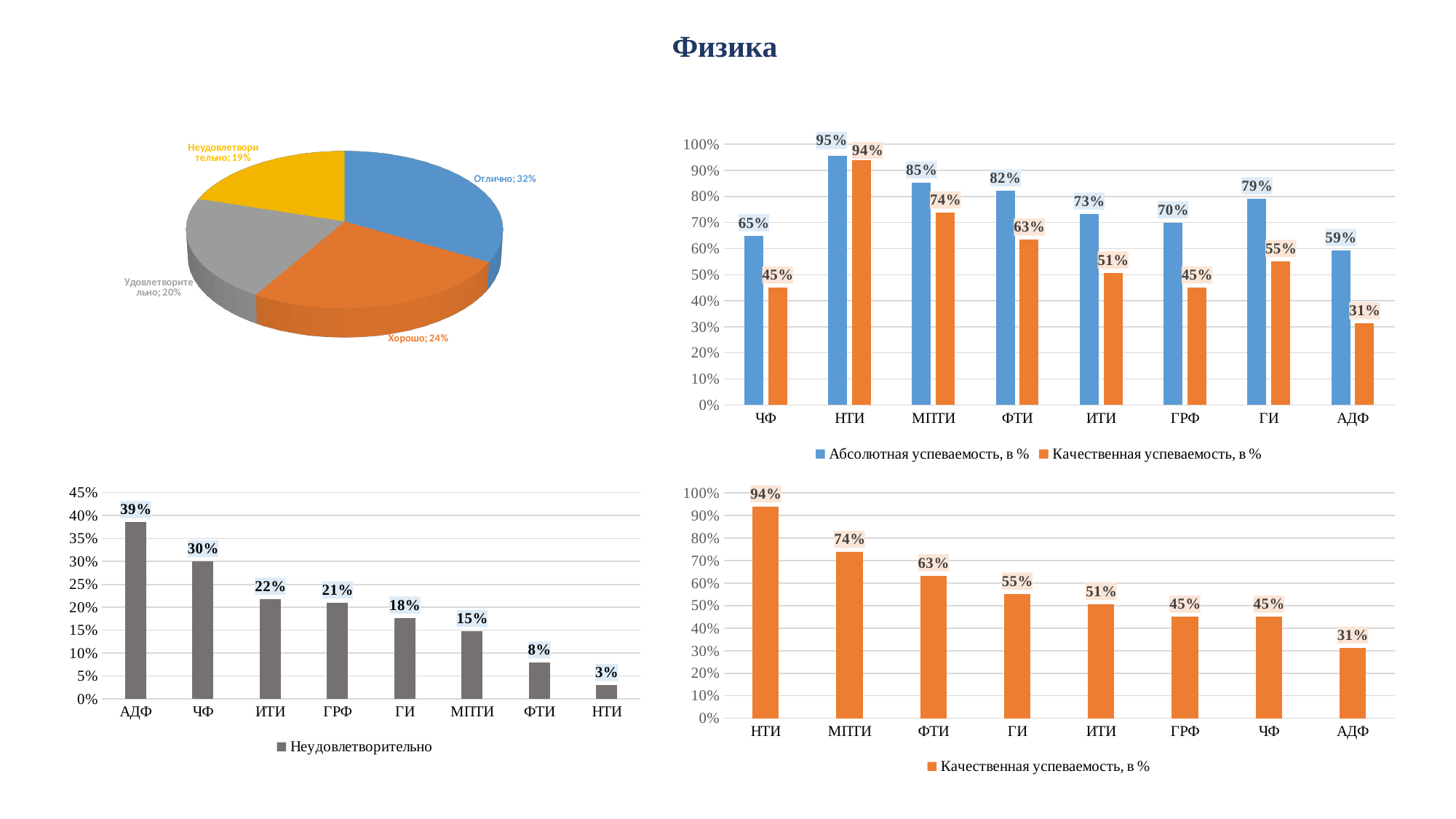
In the pie chart at the top left, what share does the 'Отлично' slice have? 32% In the grouped bar chart at the top right, which category has the lowest 'Качественная успеваемость, в %'? АДФ In the bar chart at the bottom left, what is the value for ГРФ? 21% In the grouped bar chart at the top right, what is the difference between 'Абсолютная успеваемость, в %' and 'Качественная успеваемость, в %' for ЧФ? 20% In the bar chart at the bottom left, which category has the highest value? АДФ In the bar chart at the bottom right, which is larger, the value for МПТИ or the value for ФТИ? МПТИ In the grouped bar chart at the top right, what is the value of 'Абсолютная успеваемость, в %' for НТИ? 95% In the pie chart at the top left, how many slices are there? 4 In the bar chart at the bottom right, what is the value for ГИ? 55% What kind of chart is shown at the bottom right of the slide? bar chart In the bar chart at the bottom left, do the values rise or fall from left to right along the x axis? fall In the grouped bar chart at the top right, how many series does the legend list? 2